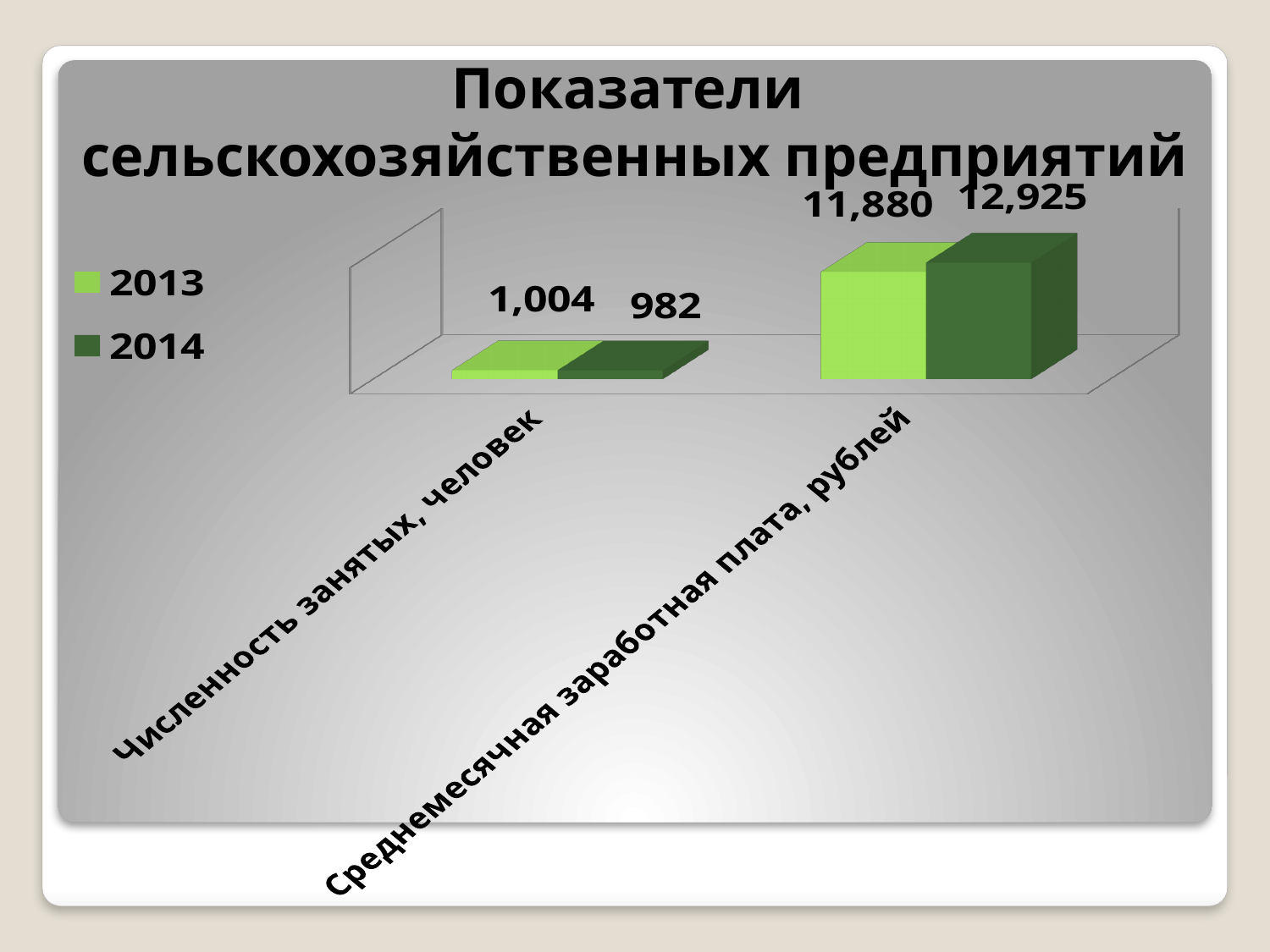
What is the difference between the 2014 and 2013 values for "Среднемесячная заработная плата, рублей"? 1,045 Which year has the lower value for "Численность занятых, человек"? 2014 What is the value for 2013 in the category "Численность занятых, человек"? 1,004 What is the value for 2014 in the category "Численность занятых, человек"? 982 What kind of chart is shown on the slide? Bar chart Which year has the higher value for "Среднемесячная заработная плата, рублей"? 2014 How many series does the legend list? 2 How many categories are shown on the x axis? 2 What is the value for 2014 in the category "Среднемесячная заработная плата, рублей"? 12,925 What is the value for 2013 in the category "Среднемесячная заработная плата, рублей"? 11,880 What is the difference between the 2013 and 2014 values for "Численность занятых, человек"? 22 What is the title of the chart? Показатели сельскохозяйственных предприятий